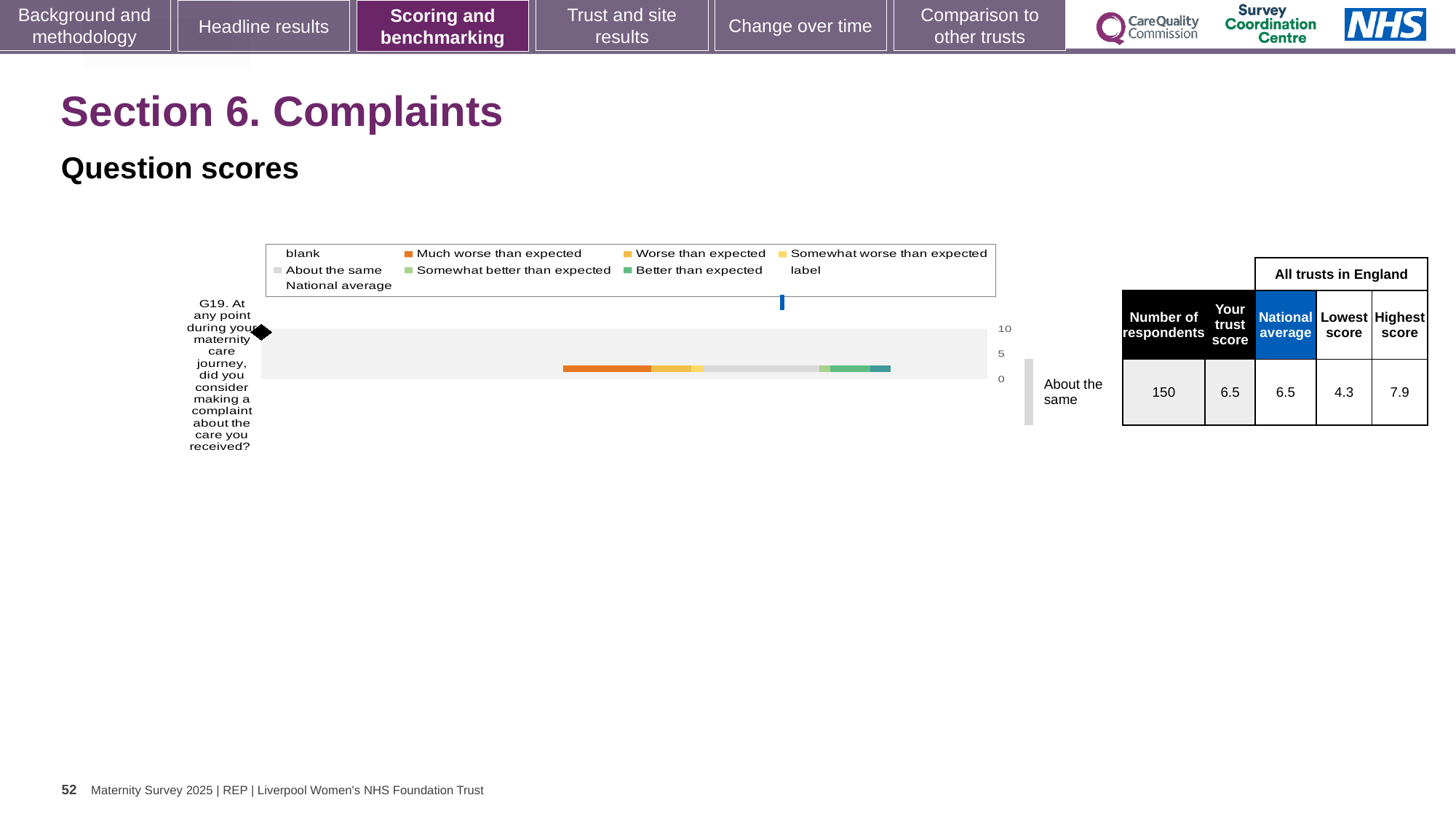
How many questions (categories) are plotted in the chart? 1 Which question is plotted in the chart? G19. At any point during your maternity care journey, did you consider making a complaint about the care you received? In the table beside the chart, how many respondents answered question G19? 150 Is the trust score for question G19 larger than, smaller than, or equal to the national average? equal In the table beside the chart, what is the lowest score among all trusts in England for question G19? 4.3 What benchmark rating is shown next to the chart for question G19? About the same In the table beside the chart, what is the trust score for question G19? 6.5 What is the highest tick value shown on the chart's axis? 10 In the table beside the chart, what is the highest score among all trusts in England for question G19? 7.9 What kind of chart is shown on the slide? bar chart In the table beside the chart, what is the national average for question G19? 6.5 What is the difference between the highest score and the lowest score for question G19 in the table beside the chart? 3.6